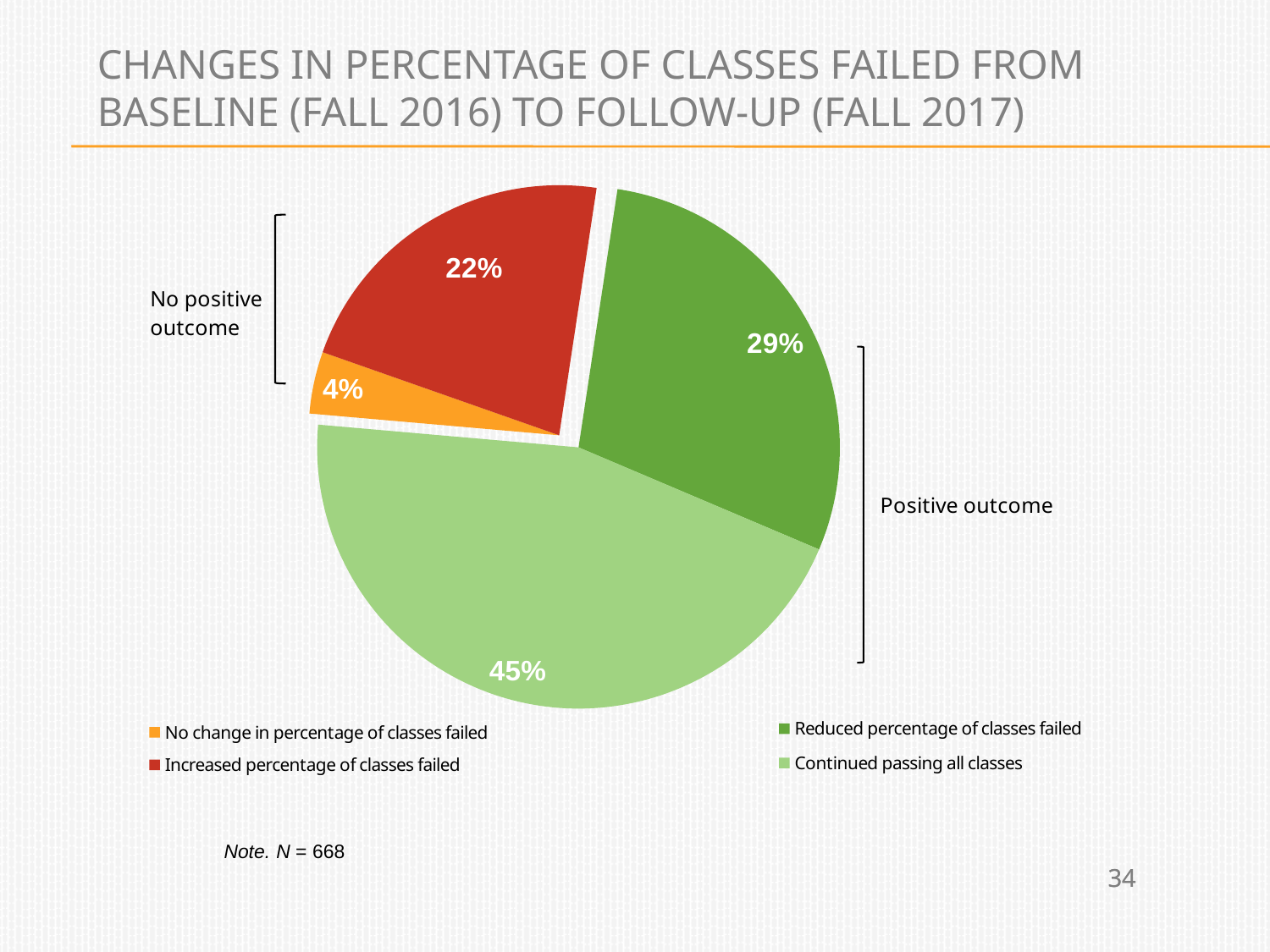
What kind of chart is shown on the slide? Pie chart What percentage of students continued passing all classes? 45% What is the combined percentage of the two slices grouped as 'Positive outcome'? 74% What percentage of students had a reduced percentage of classes failed? 29% What is the difference in percentage points between 'Continued passing all classes' and 'Reduced percentage of classes failed'? 16 What is the sample size given in the note below the chart? N = 668 What percentage of students had an increased percentage of classes failed? 22% How many slices does the pie chart have? 4 Which category has the smallest share of the pie? No change in percentage of classes failed Which is larger: 'Increased percentage of classes failed' or 'Reduced percentage of classes failed'? Reduced percentage of classes failed Which category has the largest share of the pie? Continued passing all classes What percentage of students had no change in percentage of classes failed? 4%